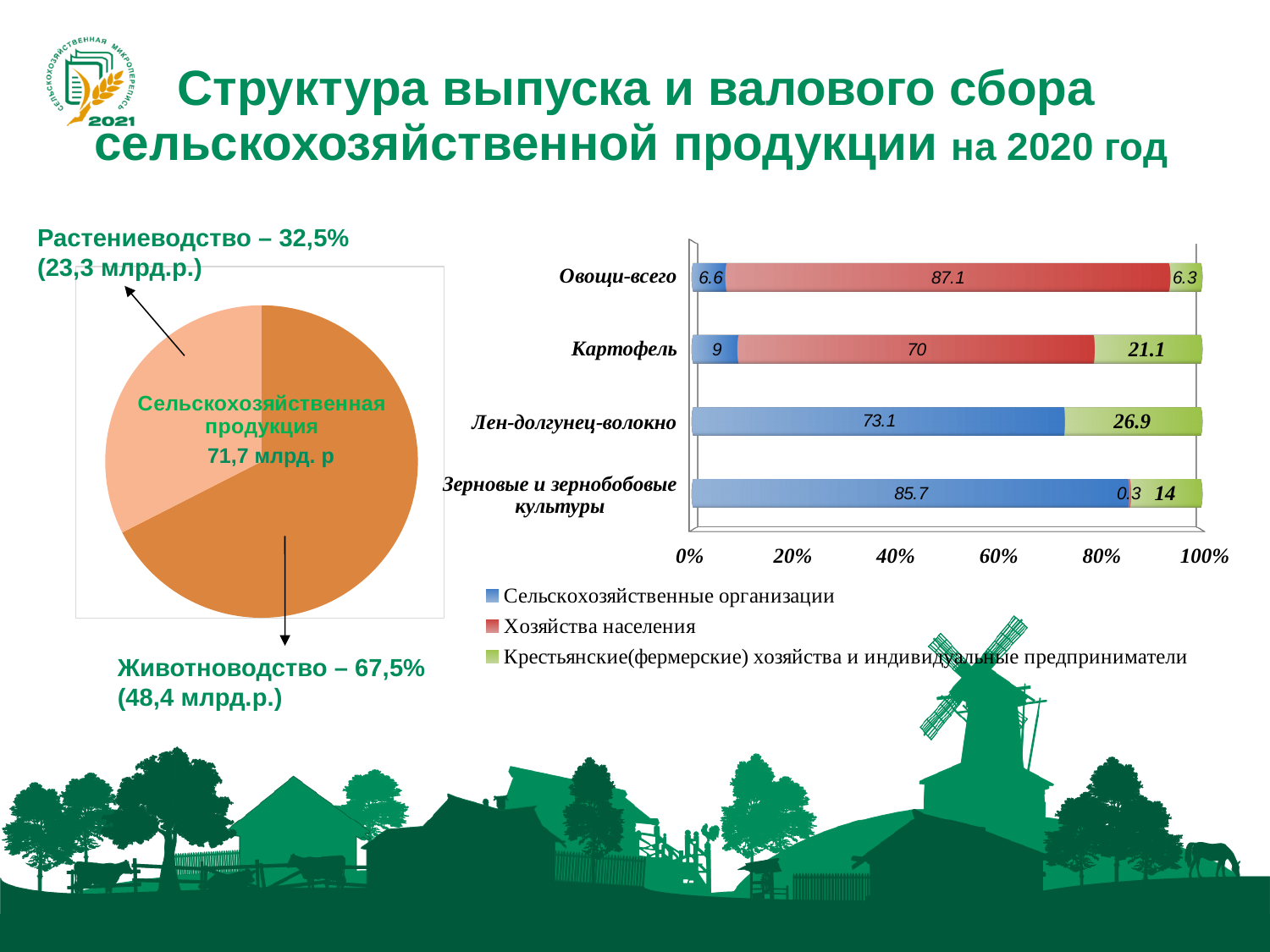
In the bar chart on the right, what is the value for Хозяйства населения in the Овощи-всего bar? 87.1 In the bar chart on the right, which is larger: the Крестьянские(фермерские) хозяйства value for Лен-долгунец-волокно or for Картофель? Лен-долгунец-волокно In the bar chart on the right, which category has the highest value for Сельскохозяйственные организации? Зерновые и зернобобовые культуры In the pie chart on the left, what share does Животноводство have? 67,5% In the bar chart on the right, what is the value for Крестьянские(фермерские) хозяйства и индивидуальные предприниматели in the Картофель bar? 21.1 How many categories are shown in the bar chart on the right? 4 In the bar chart on the right, what is the value for Сельскохозяйственные организации in the Лен-долгунец-волокно bar? 73.1 What kind of chart is the chart on the right of the slide? Stacked bar chart How many series does the legend of the bar chart on the right list? 3 In the bar chart on the right, which category has the lowest value for Крестьянские(фермерские) хозяйства и индивидуальные предприниматели? Овощи-всего In the bar chart on the right, what is the value for Хозяйства населения in the Зерновые и зернобобовые культуры bar? 0.3 In the bar chart on the right, what is the difference between the Хозяйства населения value and the Сельскохозяйственные организации value for Картофель? 61